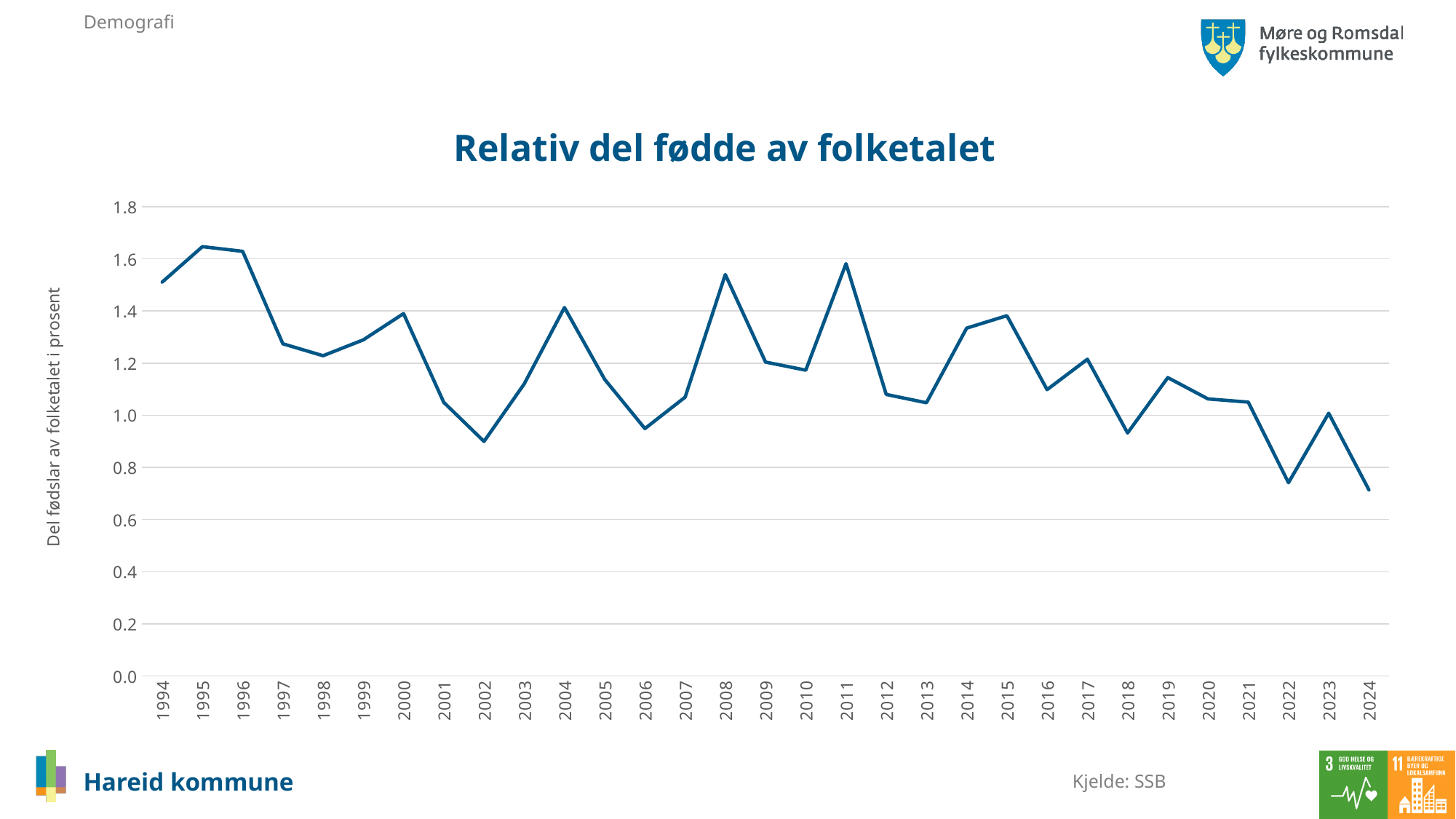
What is the title of the chart? Relativ del fødde av folketalet Overall, do the values rise or fall from 1994 to 2024? fall Is the value for 2018 greater or less than 1.0? less Is the value for 2008 greater or less than 1.4? greater Is the value for 2002 greater or less than 1.0? less Which year has the larger value, 2008 or 2002? 2008 What is the label on the vertical axis of the chart? Del fødslar av folketalet i prosent What kind of chart is shown on the slide? line chart Which year has the larger value, 1995 or 2024? 1995 How many years are plotted along the x axis of the chart? 31